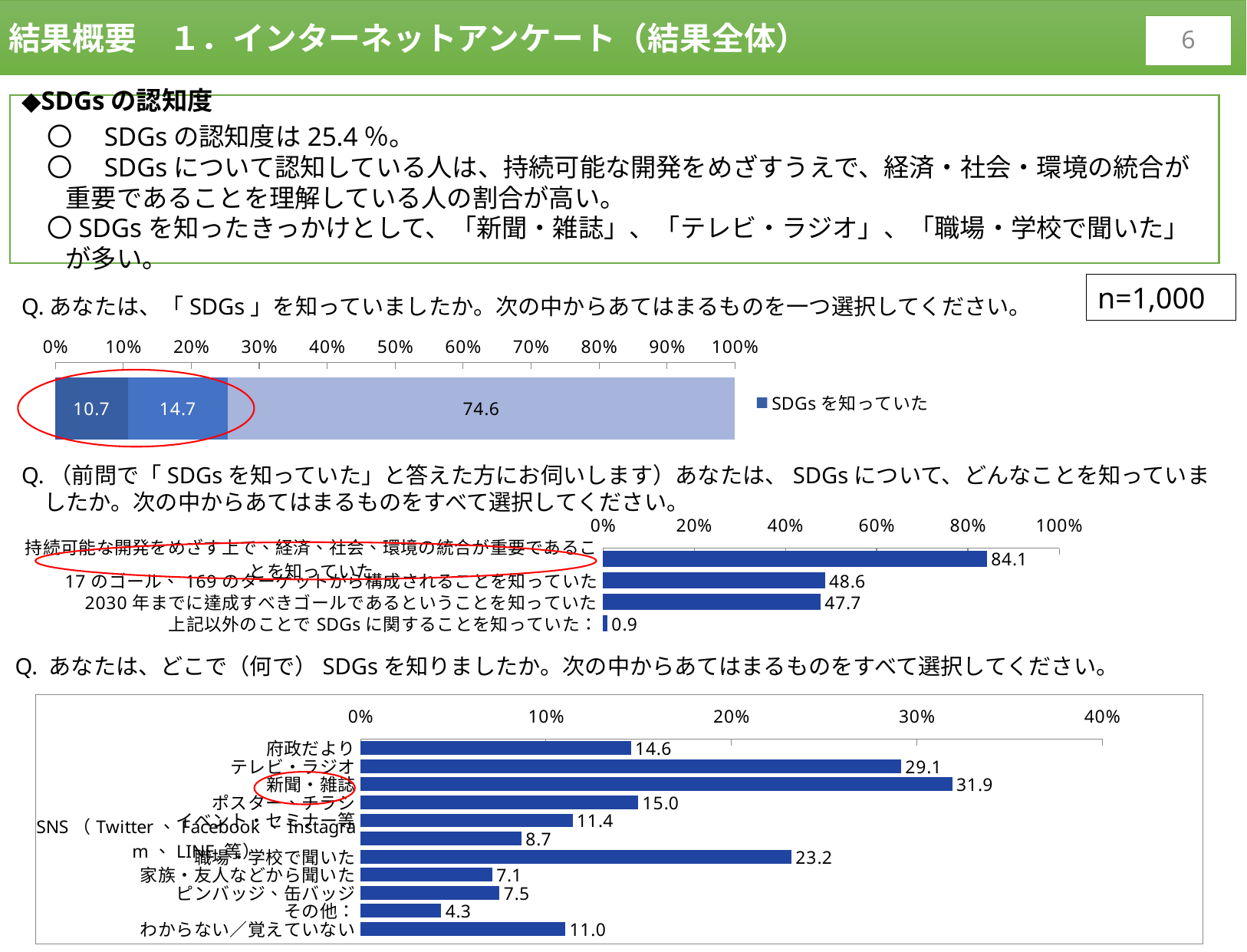
In the middle chart (what respondents knew about SDGs), what is the value for 2030年までに達成すべきゴールであるということを知っていた? 47.7 In the bottom chart (where respondents learned about SDGs), what is the difference between 新聞・雑誌 and テレビ・ラジオ? 2.8 In the middle chart (what respondents knew about SDGs), which category has the highest value? 持続可能な開発をめざす上で、経済、社会、環境の統合が重要であることを知っていた In the bottom chart (where respondents learned about SDGs), how many categories are plotted? 11 In the bottom chart (where respondents learned about SDGs), which category has the highest value? 新聞・雑誌 In the bottom chart (where respondents learned about SDGs), what is the value for 職場・学校で聞いた? 23.2 In the bottom chart (where respondents learned about SDGs), which is larger: 府政だより or わからない／覚えていない? 府政だより What kind of chart is the bottom chart (where respondents learned about SDGs)? bar chart In the top stacked bar chart, what is the value of the largest segment? 74.6 In the bottom chart (where respondents learned about SDGs), what is the value for 新聞・雑誌? 31.9 In the bottom chart (where respondents learned about SDGs), which category has the lowest value? その他 In the middle chart (what respondents knew about SDGs), what is the difference between the highest value (84.1) and 17のゴール、169のターゲットから構成されることを知っていた? 35.5